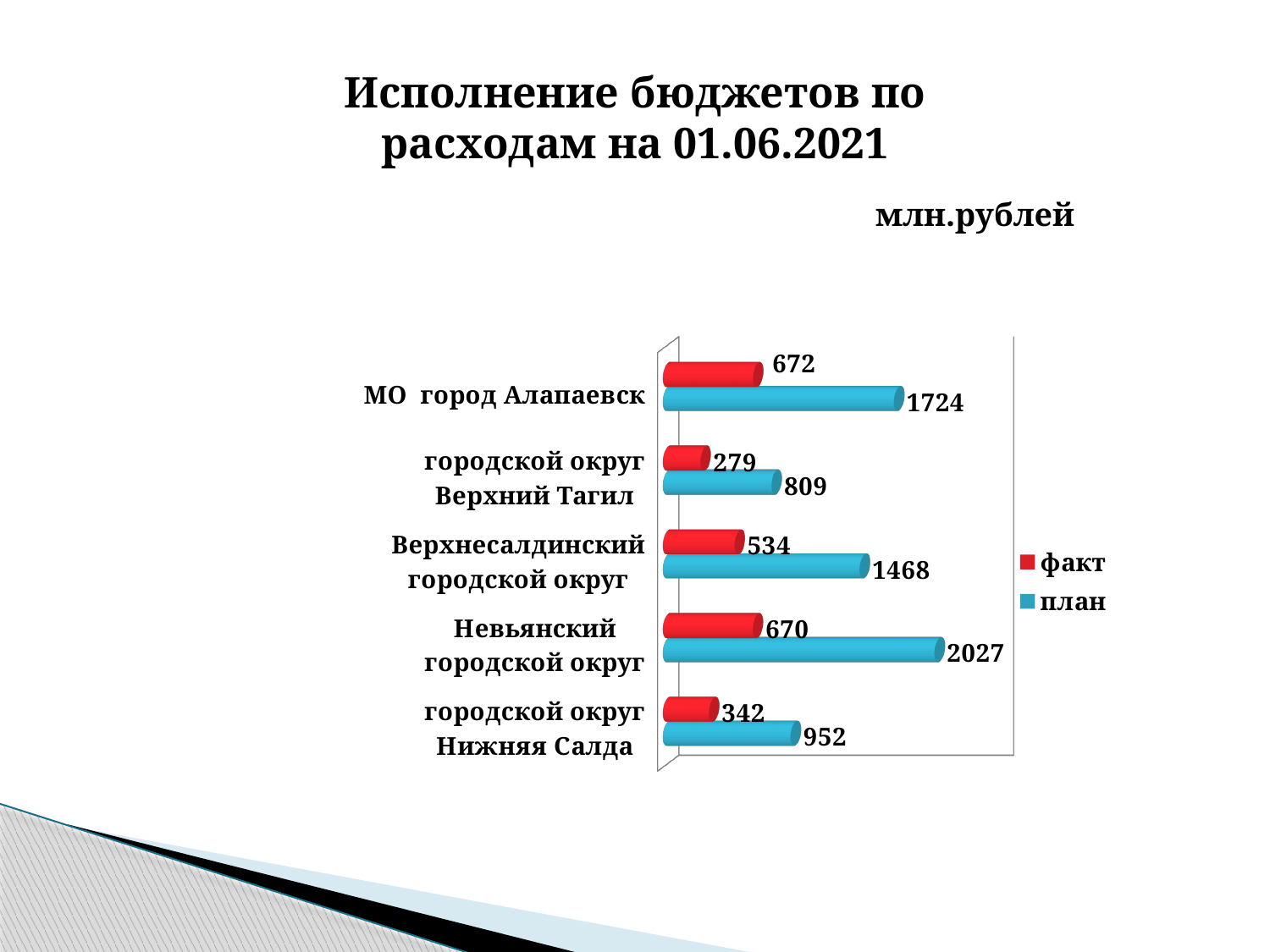
What is the факт value for городской округ Верхний Тагил? 279 What is the difference between the план and факт values for Верхнесалдинский городской округ? 934 How many series does the legend list? 2 Which is larger: the план value for городской округ Нижняя Салда or the план value for городской округ Верхний Тагил? городской округ Нижняя Салда What is the план value for Невьянский городской округ? 2027 Which colour represents the факт series in the legend? red How many categories are shown in the chart? 5 Which category has the highest план value? Невьянский городской округ Which category has the lowest факт value? городской округ Верхний Тагил What is the факт value for МО город Алапаевск? 672 What unit is stated for the values on the slide? млн.рублей What kind of chart is shown on the slide? bar chart